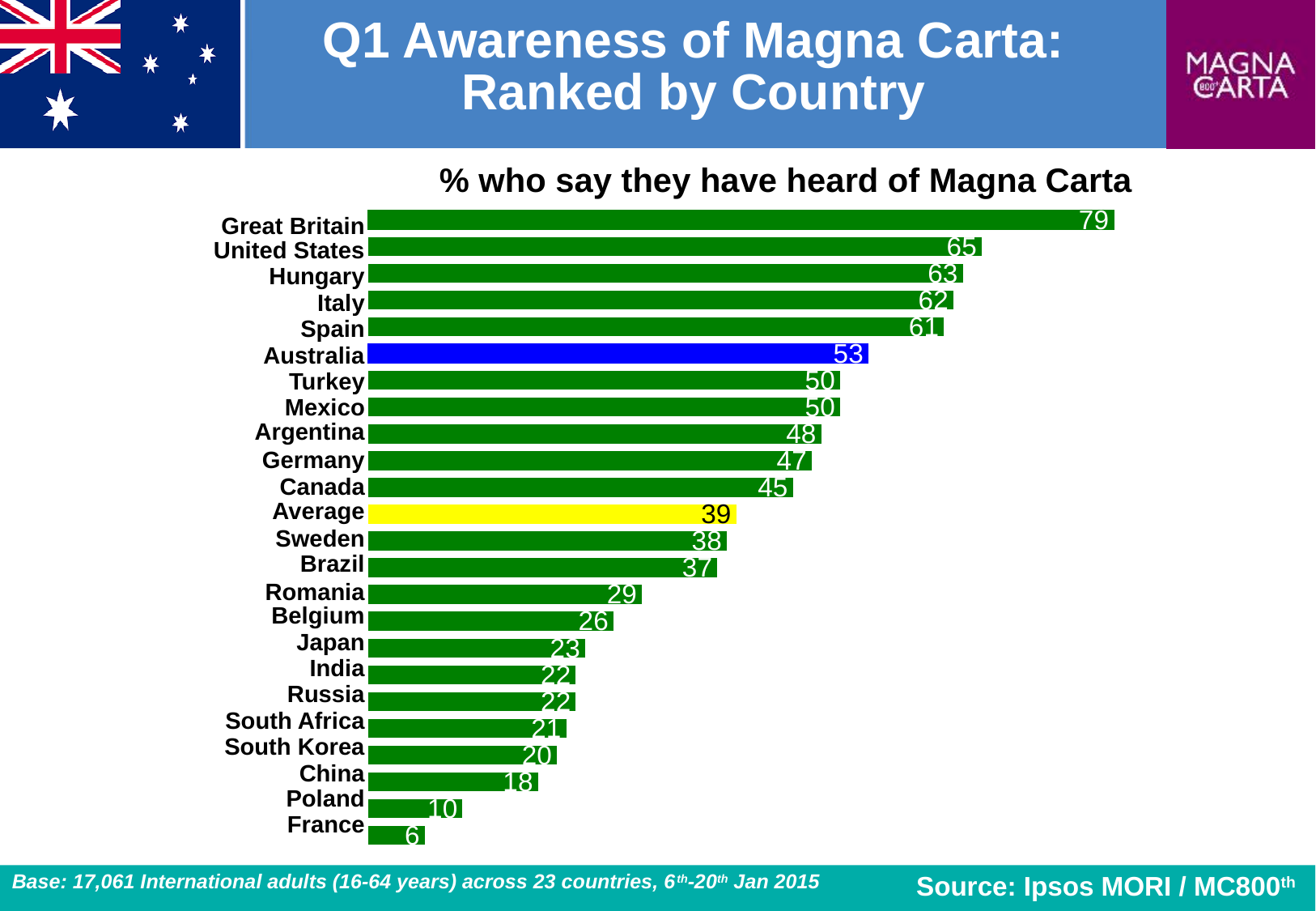
Which country has the highest value? Great Britain Which has a larger value, Germany or Canada? Germany Which has a larger value, Poland or China? China How many bars are plotted on the chart, including the Average bar? 24 What kind of chart is shown on the slide? Bar chart What is the value shown for the Average bar? 39 What is the difference between the values for Australia and the Average? 14 What colour is the Australia bar? Blue What is the difference between the values for Great Britain and France? 73 What is the value for Australia? 53 What is the value for Great Britain? 79 Which country has the lowest value? France